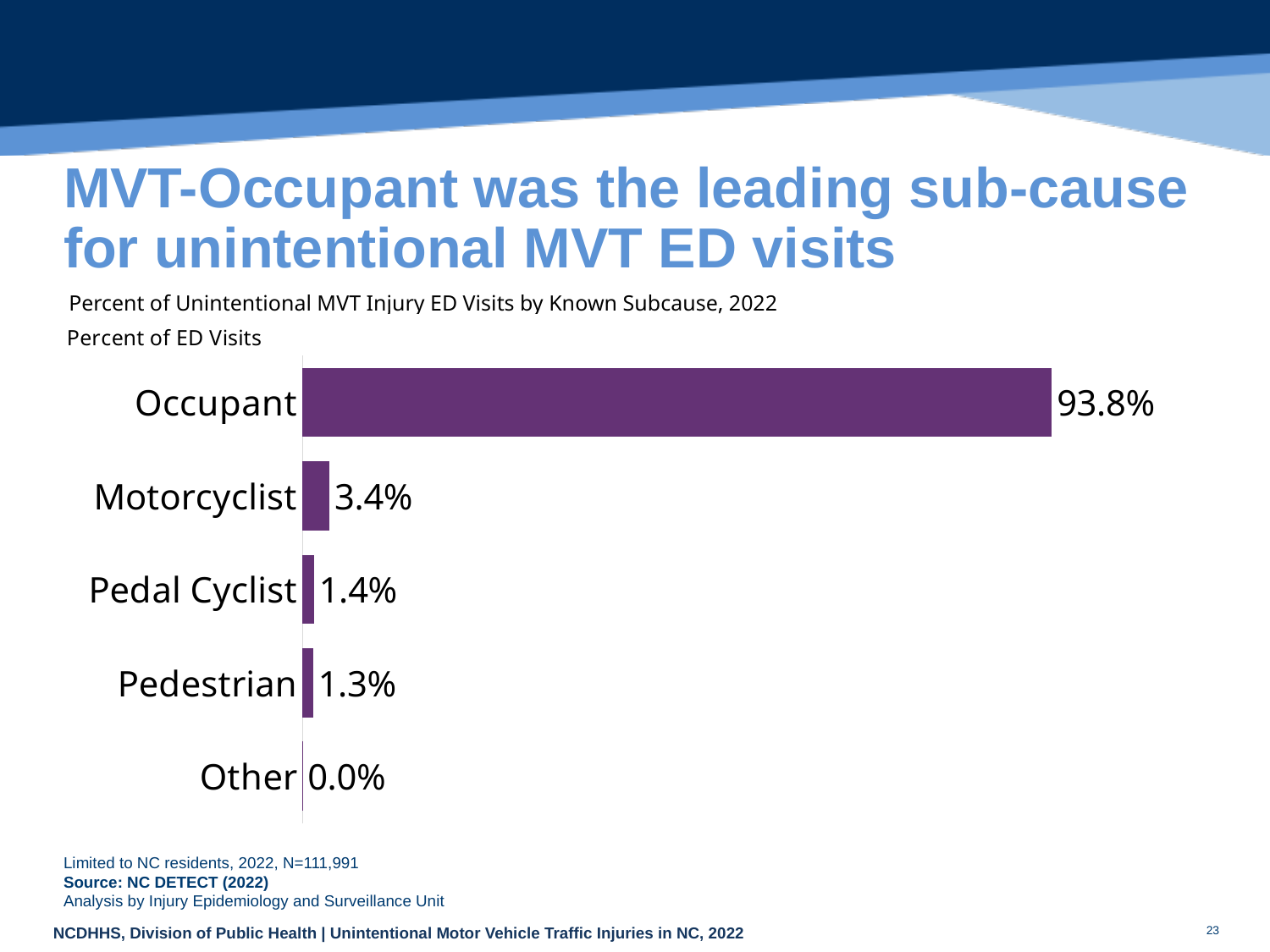
What kind of chart is shown on the slide? Bar chart What percent of unintentional MVT injury ED visits were for Motorcyclist? 3.4% What percent of unintentional MVT injury ED visits were for Pedestrian? 1.3% What percent of unintentional MVT injury ED visits were for Pedal Cyclist? 1.4% What is the difference in percent of ED visits between Occupant and Motorcyclist? 90.4% What percent of unintentional MVT injury ED visits were for Other? 0.0% How many subcause categories are shown in the chart? 5 Which has a larger percent of ED visits, Motorcyclist or Pedal Cyclist? Motorcyclist Which subcause has the lowest percent of ED visits? Other What percent of unintentional MVT injury ED visits were for Occupant? 93.8% What is the difference in percent of ED visits between Pedal Cyclist and Pedestrian? 0.1% Which subcause has the highest percent of ED visits? Occupant